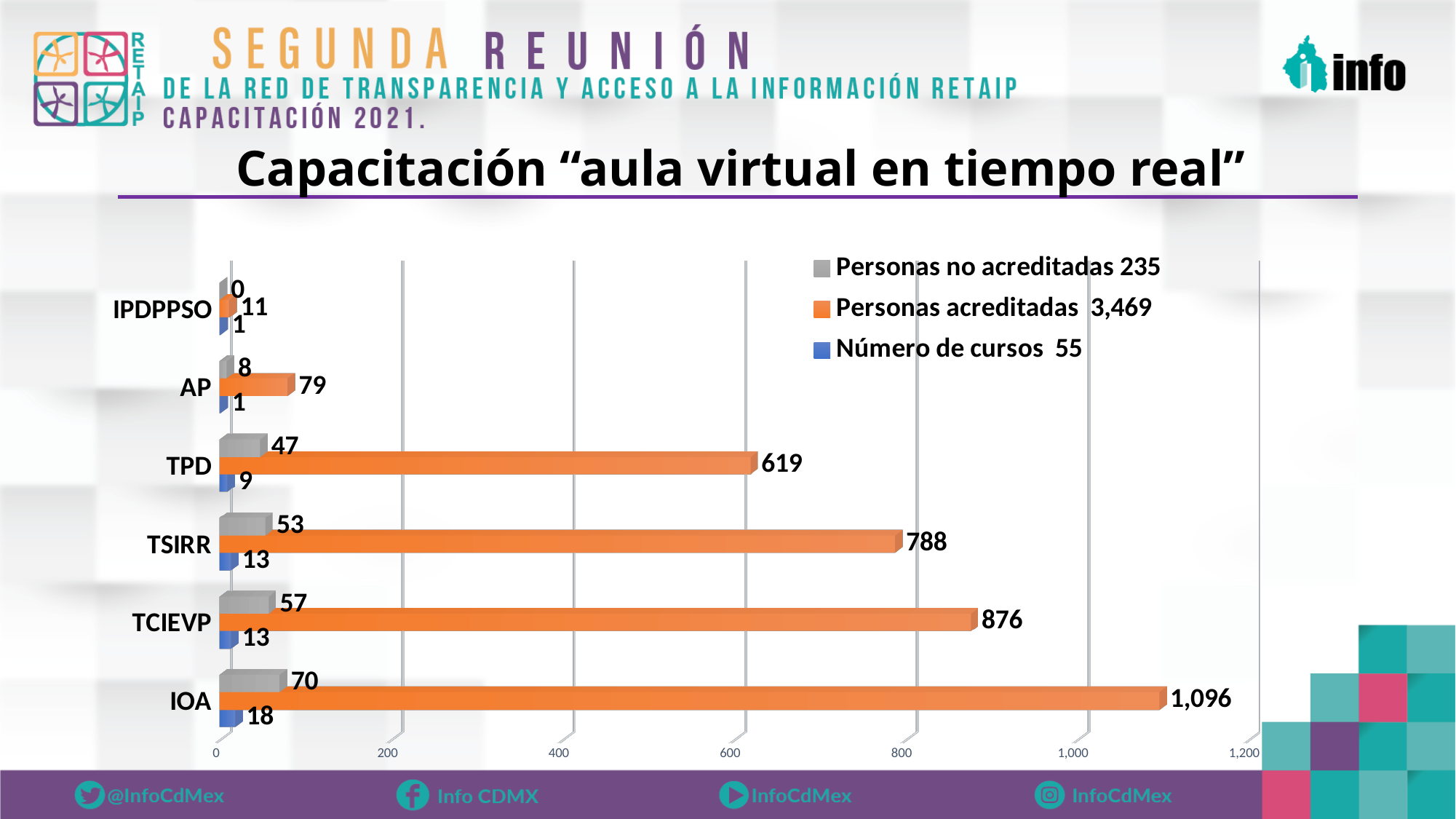
How many series does the legend list? 3 What total for Personas acreditadas is shown in the legend? 3,469 Which category has the highest value for Personas acreditadas? IOA How many Personas no acreditadas are shown for TPD? 47 How many categories are shown on the vertical axis of the chart? 6 Which colour represents Número de cursos in the chart? blue What is the difference in Personas acreditadas between TCIEVP and TSIRR? 88 How many Personas acreditadas are shown for IOA? 1,096 What kind of chart is shown on the slide? bar chart Which category has the lowest value for Personas acreditadas? IPDPPSO Which has more Personas no acreditadas, TCIEVP or AP? TCIEVP What is the Número de cursos value for TSIRR? 13